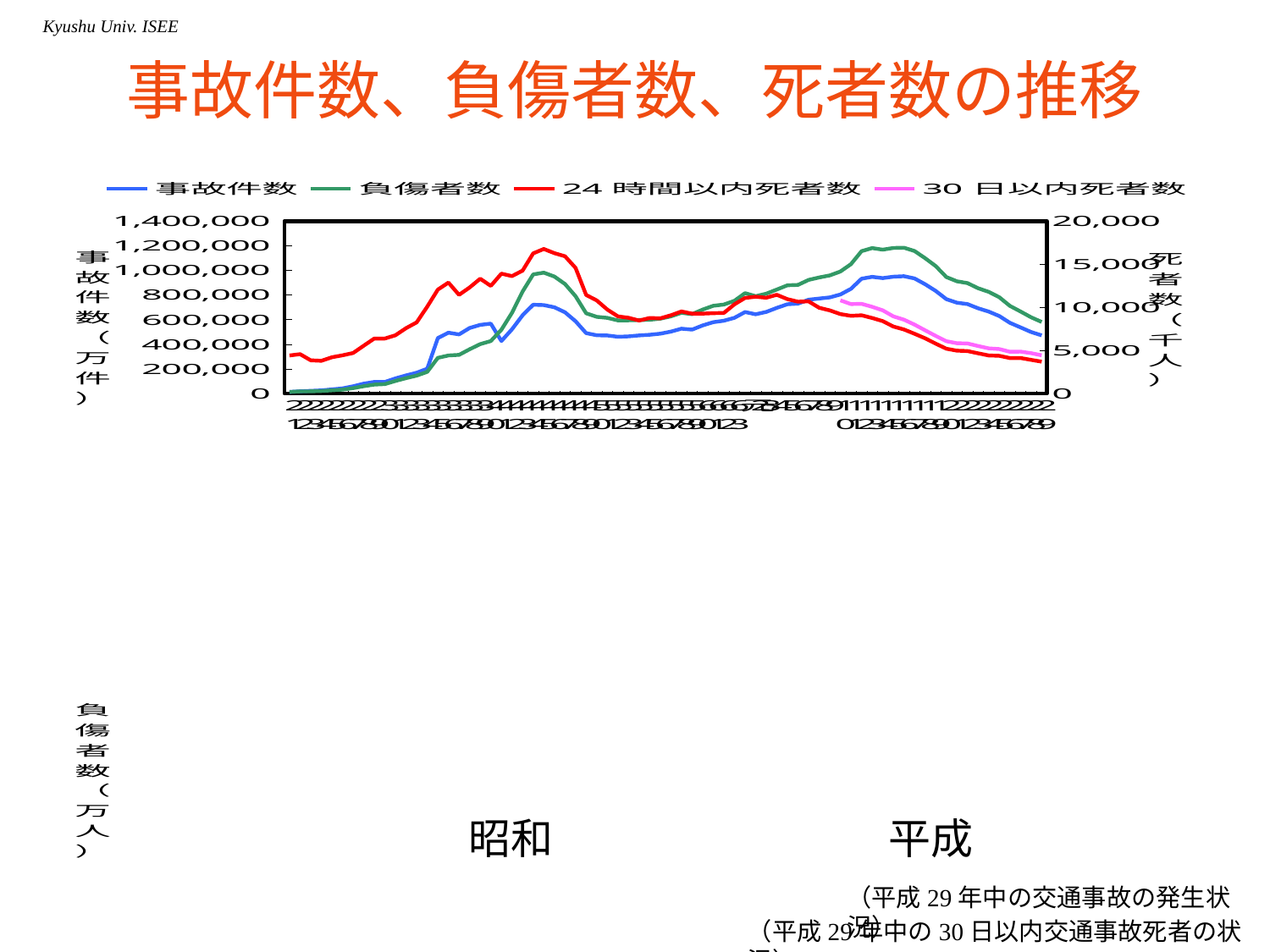
At the right end of the chart, which series is higher on the right axis: 24 時間以内死者数 or 30 日以内死者数? 30 日以内死者数 At the right end of the chart, which series is higher on the left axis: 事故件数 or 負傷者数? 負傷者数 What kind of chart is shown on the slide? line chart Is the peak value of the 負傷者数 series greater or less than 1,000,000 on the left axis? greater Is the peak value of the 事故件数 series greater or less than 1,000,000 on the left axis? less At the right end of the chart, is the 24 時間以内死者数 value greater or less than 5,000 on the right axis? less What is the highest tick value shown on the left vertical axis? 1,400,000 Which series is drawn in red in the legend? 24 時間以内死者数 Does the 30 日以内死者数 series rise or fall from left to right over the period it is plotted? fall How many series does the legend list? 4